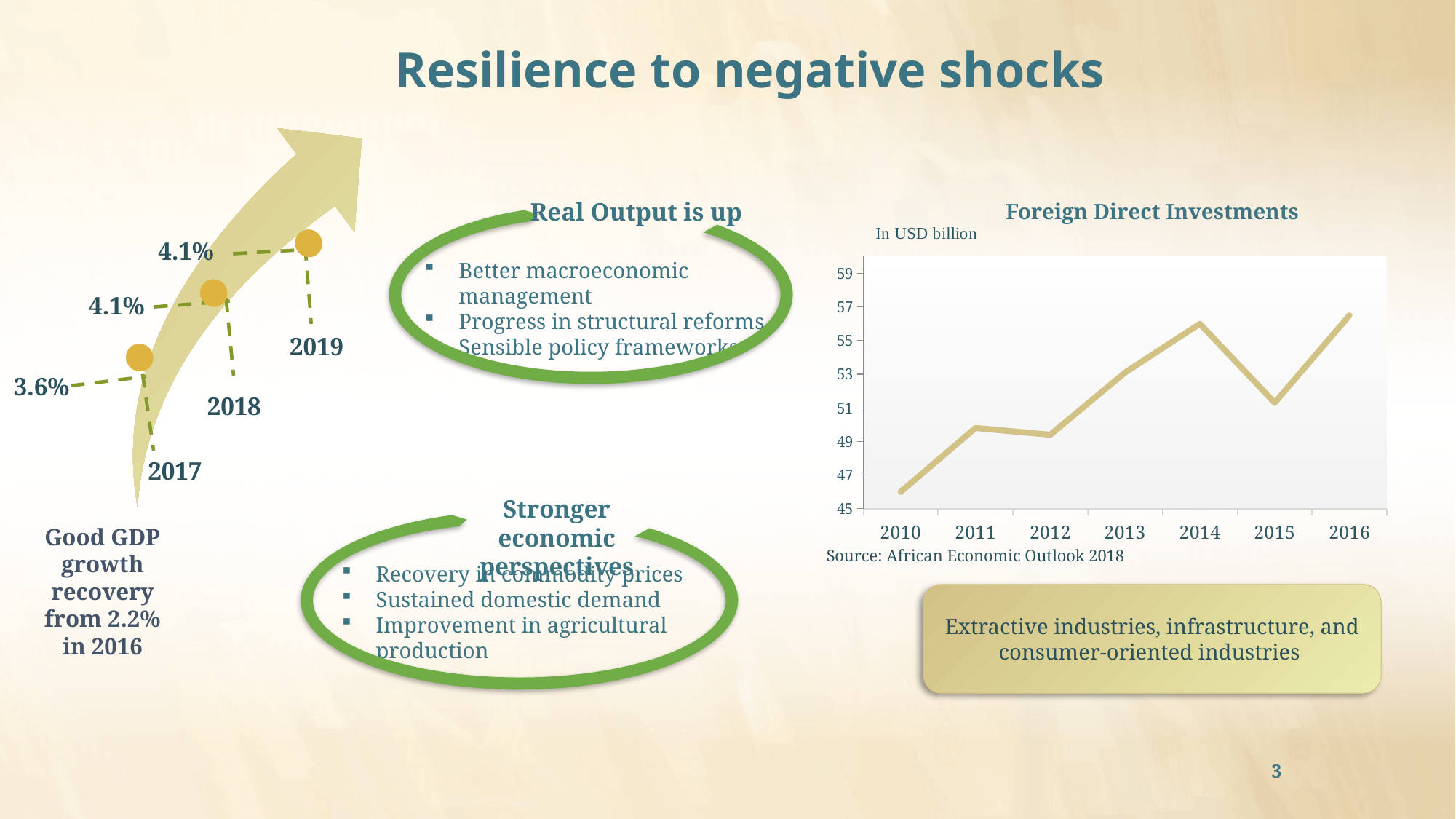
What source is cited below the Foreign Direct Investments chart? African Economic Outlook 2018 On the Foreign Direct Investments chart, which is larger, the value for 2014 or the value for 2015? 2014 On the Foreign Direct Investments chart, is the value for 2014 greater or less than 55? greater On the Foreign Direct Investments chart, do values rise or fall from 2014 to 2015? fall On the Foreign Direct Investments chart, which is larger, the value for 2013 or the value for 2012? 2013 On the Foreign Direct Investments chart, is the value for 2010 greater or less than 47? less How many years are plotted on the Foreign Direct Investments chart? 7 What unit is stated for the Foreign Direct Investments chart? In USD billion On the Foreign Direct Investments chart, is the value for 2011 greater or less than 51? less Which year has the lowest value on the Foreign Direct Investments chart? 2010 What kind of chart is the Foreign Direct Investments chart? line chart